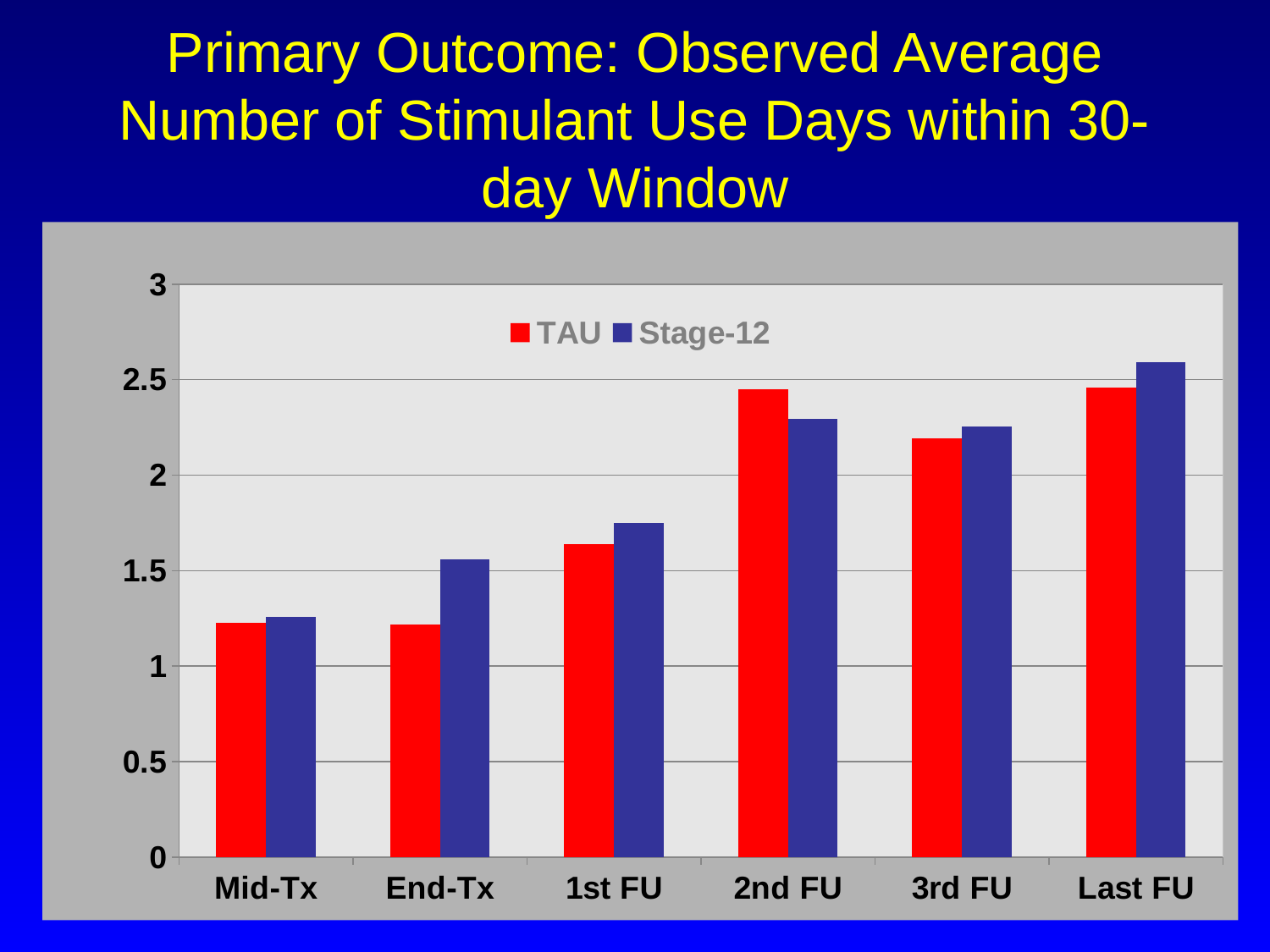
What kind of chart is shown on the slide? bar chart At which time point is the Stage-12 value highest? Last FU Do the Stage-12 values generally rise or fall from Mid-Tx to Last FU? rise Is the Stage-12 value at Last FU greater or less than 2.5? greater How many series does the legend list? 2 At End-Tx, which series has the larger value, TAU or Stage-12? Stage-12 At 2nd FU, which series has the larger value, TAU or Stage-12? TAU Which series is shown in red in the legend? TAU How many time-point categories are shown on the x axis? 6 At which time point is the Stage-12 value lowest? Mid-Tx Is the TAU value at 1st FU greater or less than 2? less Is the TAU value at 2nd FU greater or less than 2? greater